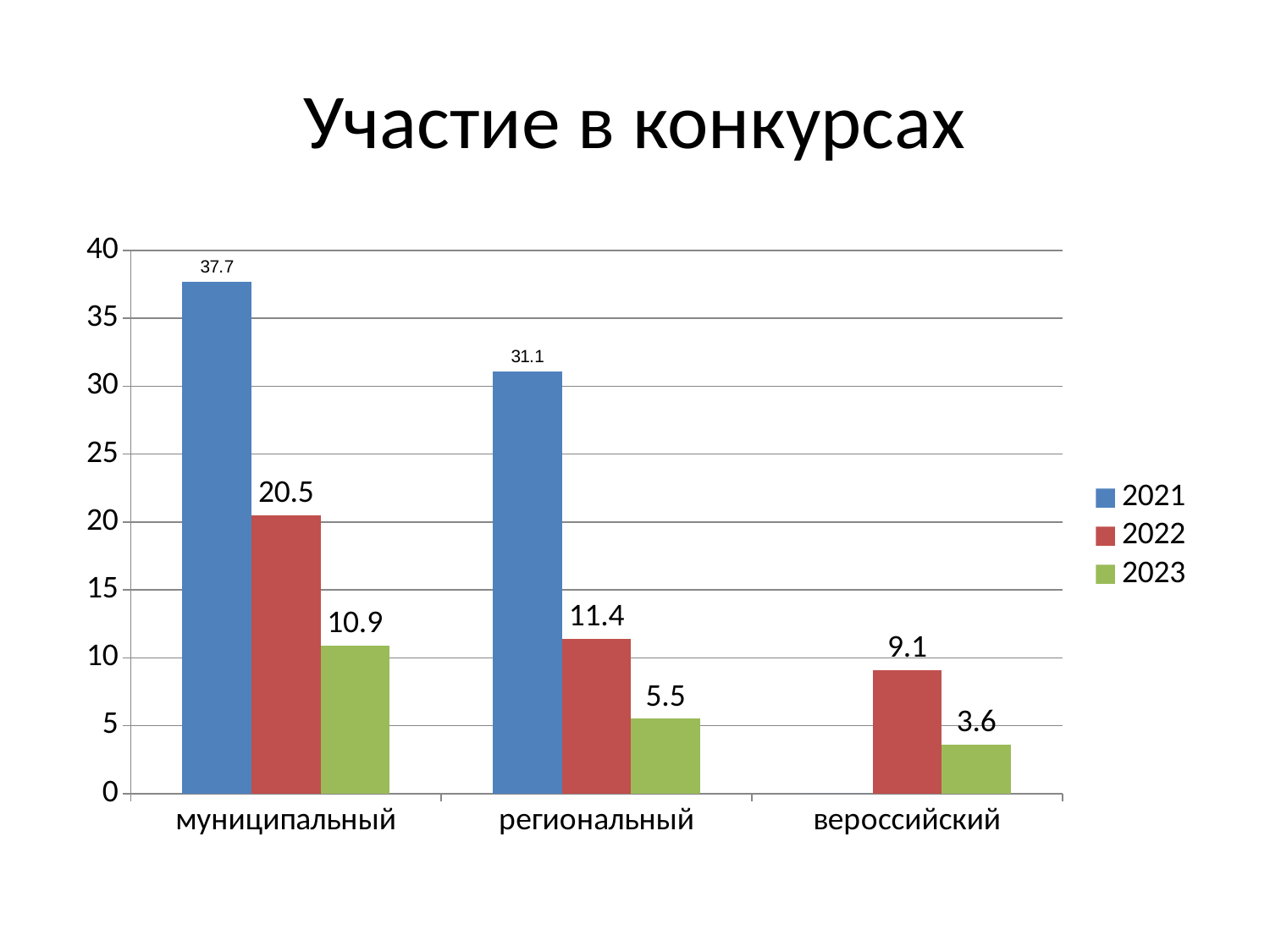
What is the value for 2023 in the региональный category? 5.5 What is the value for 2022 in the вероссийский category? 9.1 What is the difference between the 2022 and 2023 values in the региональный category? 5.9 Which category has the highest value for the 2022 series? муниципальный What kind of chart is shown on the slide? bar chart Is the 2021 value for региональный greater or less than 30? greater What is the value for 2021 in the муниципальный category? 37.7 Which is larger: the 2023 value for муниципальный or the 2022 value for вероссийский? 2023 value for муниципальный Which category has the lowest value for the 2023 series? вероссийский How many series does the legend list? 3 How many categories are shown on the x axis? 3 What is the difference between the 2021 values for муниципальный and региональный? 6.6